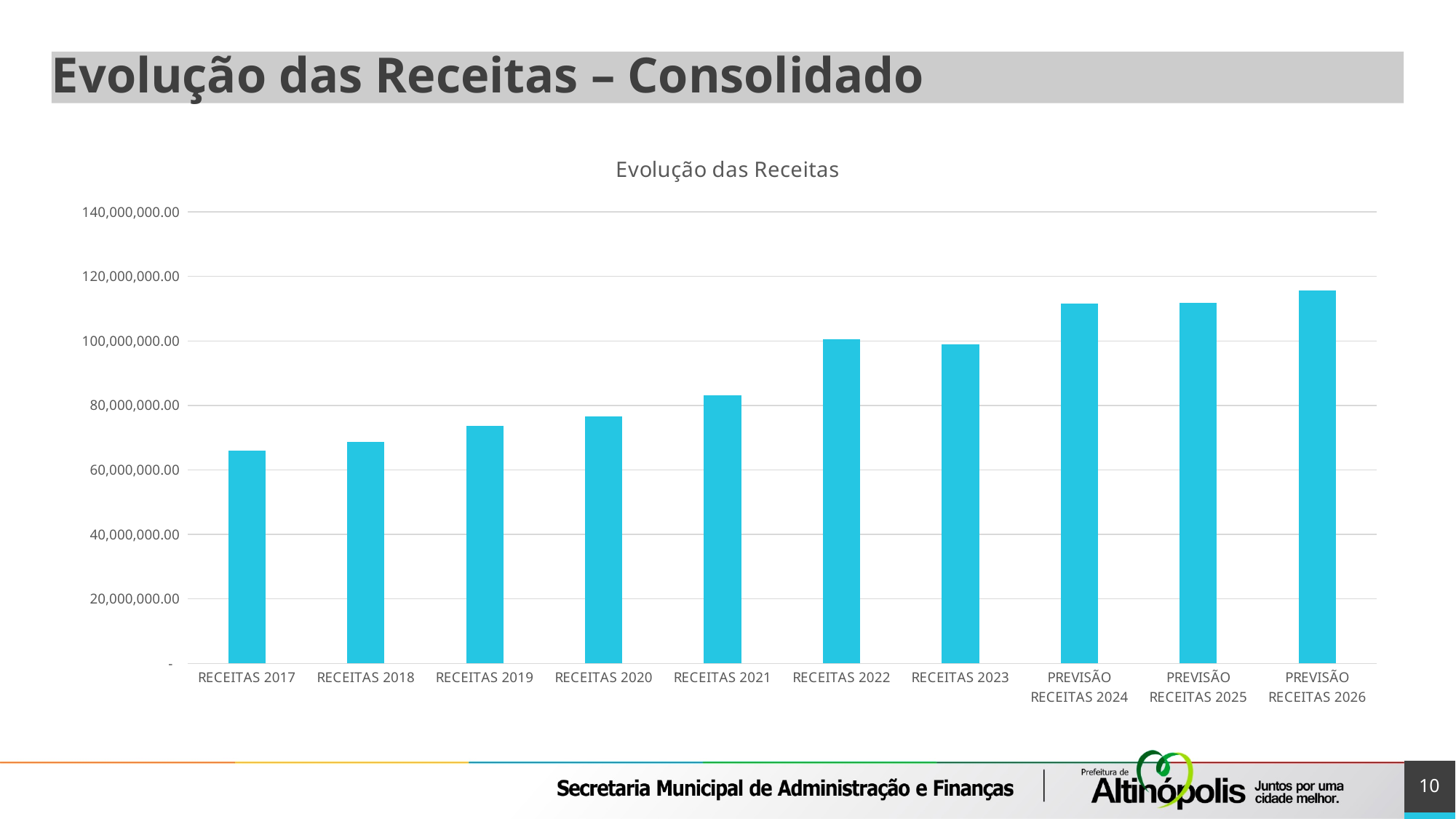
Is the value for RECEITAS 2017 greater or less than 80,000,000.00? less Which category has the lowest value in the chart? RECEITAS 2017 What kind of chart is shown on the slide? Bar chart Is the value for RECEITAS 2019 greater or less than 80,000,000.00? less Do the values generally rise or fall from RECEITAS 2017 to PREVISÃO RECEITAS 2026? Rise Is the value for PREVISÃO RECEITAS 2026 greater or less than 120,000,000.00? less Which is larger, the value for RECEITAS 2021 or the value for RECEITAS 2020? RECEITAS 2021 What is the title of the chart? Evolução das Receitas How many categories (bars) are plotted in the chart? 10 Which category has the highest value in the chart? PREVISÃO RECEITAS 2026